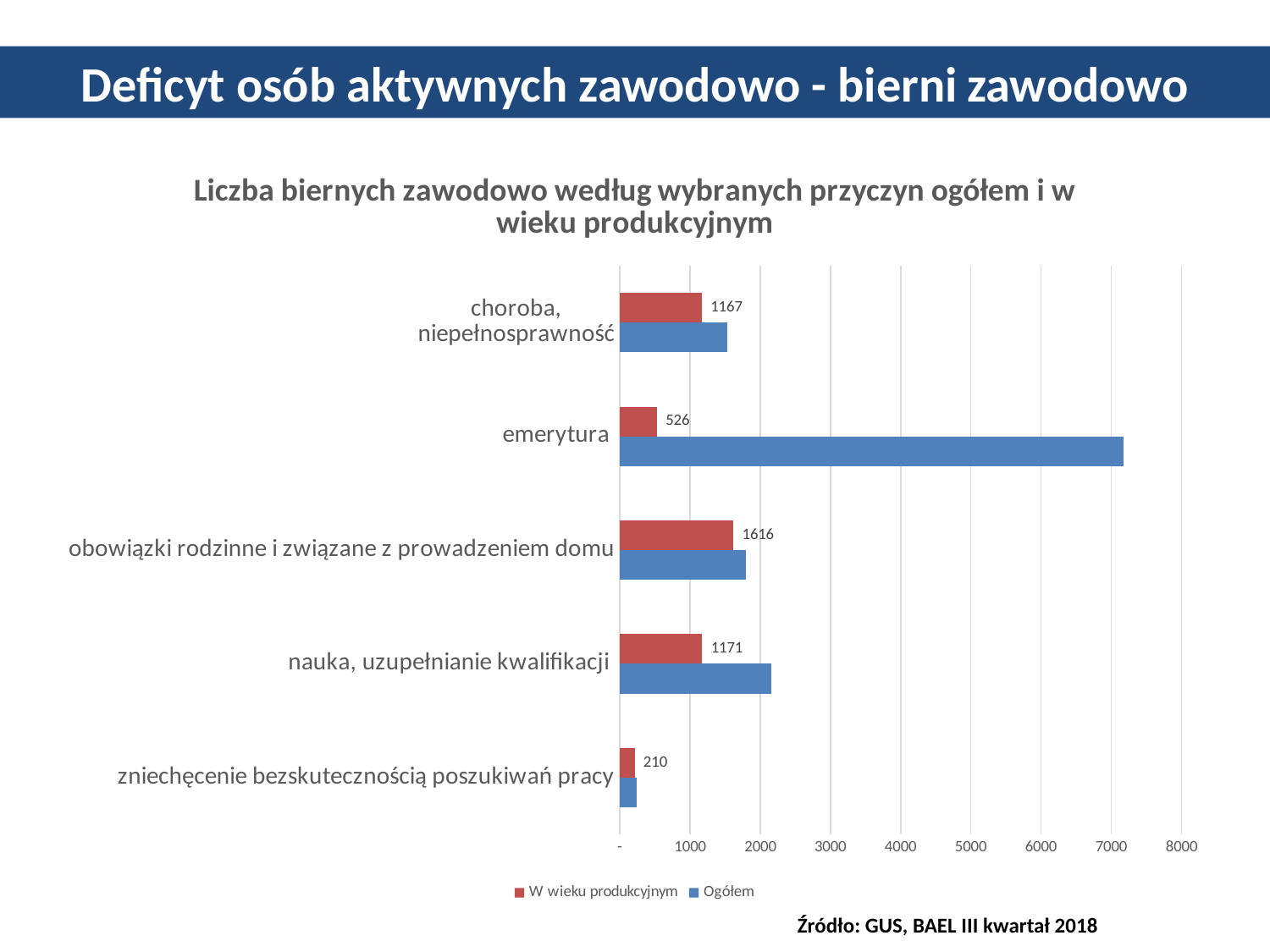
Which category has the lowest value for 'W wieku produkcyjnym'? zniechęcenie bezskutecznością poszukiwań pracy What is the value of 'W wieku produkcyjnym' for 'emerytura'? 526 What is the value of 'W wieku produkcyjnym' for 'obowiązki rodzinne i związane z prowadzeniem domu'? 1616 Which category has the highest value for 'W wieku produkcyjnym'? obowiązki rodzinne i związane z prowadzeniem domu What is the difference between the 'W wieku produkcyjnym' values for 'obowiązki rodzinne i związane z prowadzeniem domu' and 'nauka, uzupełnianie kwalifikacji'? 445 Is the 'Ogółem' value for 'emerytura' greater or less than 6000? greater Which category has the highest value for 'Ogółem'? emerytura What is the value of 'W wieku produkcyjnym' for 'zniechęcenie bezskutecznością poszukiwań pracy'? 210 How many series does the legend list? 2 How many categories are shown on the chart? 5 Is the 'Ogółem' value for 'zniechęcenie bezskutecznością poszukiwań pracy' greater or less than 1000? less Which is larger for 'W wieku produkcyjnym': 'emerytura' or 'zniechęcenie bezskutecznością poszukiwań pracy'? emerytura